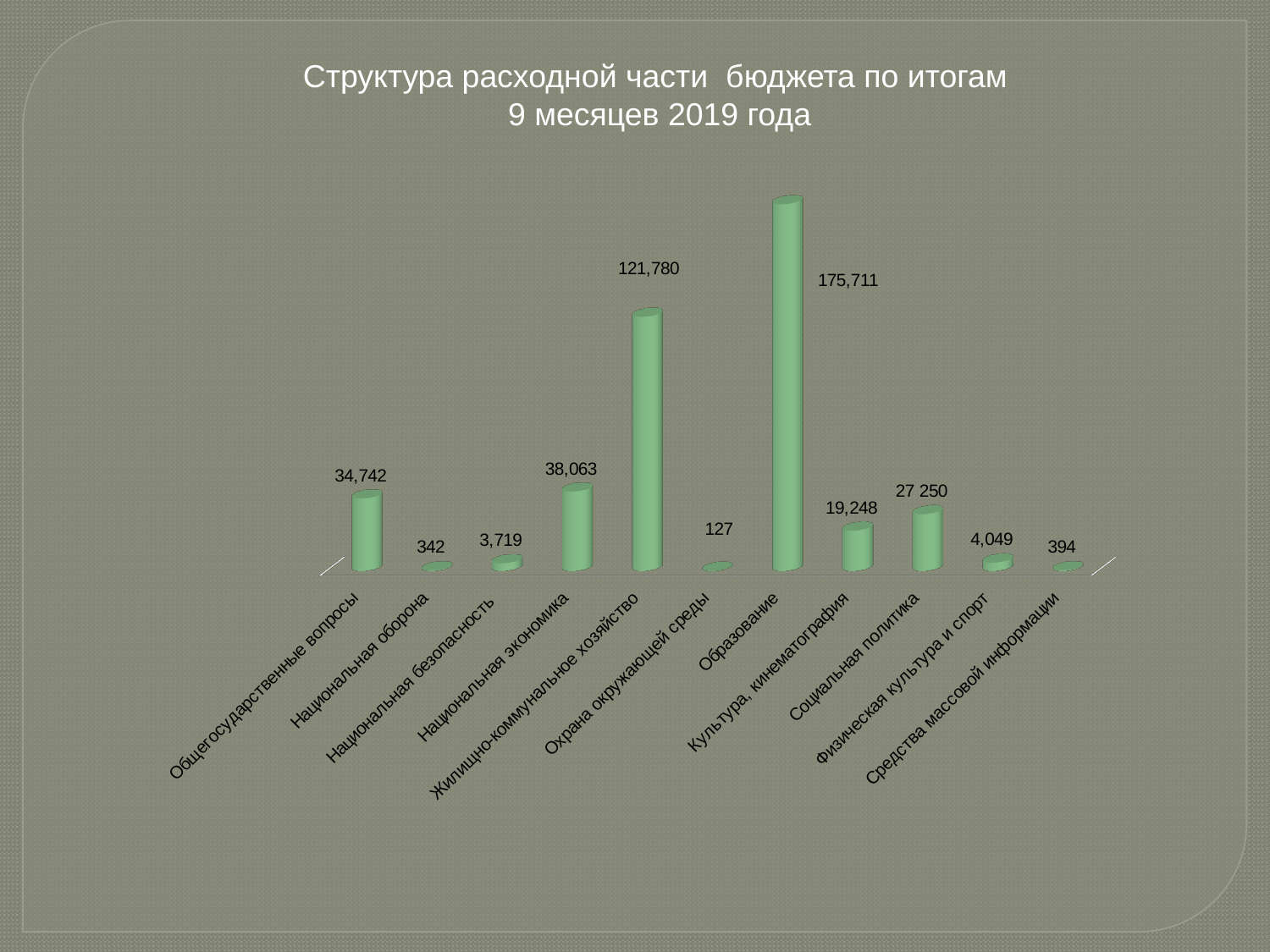
What is the difference between the values for Образование and Жилищно-коммунальное хозяйство? 53,931 Which category has the lowest value? Охрана окружающей среды Which is larger, the value for Культура, кинематография or the value for Социальная политика? Социальная политика What is the difference between the values for Национальная экономика and Общегосударственные вопросы? 3,321 What kind of chart is shown on the slide? Bar chart What is the value for Социальная политика? 27 250 What is the value for Национальная безопасность? 3,719 Which category has the highest value? Образование What is the title of the chart? Структура расходной части бюджета по итогам 9 месяцев 2019 года How many categories are shown in the chart? 11 What is the value for Жилищно-коммунальное хозяйство? 121,780 What is the value for Образование? 175,711